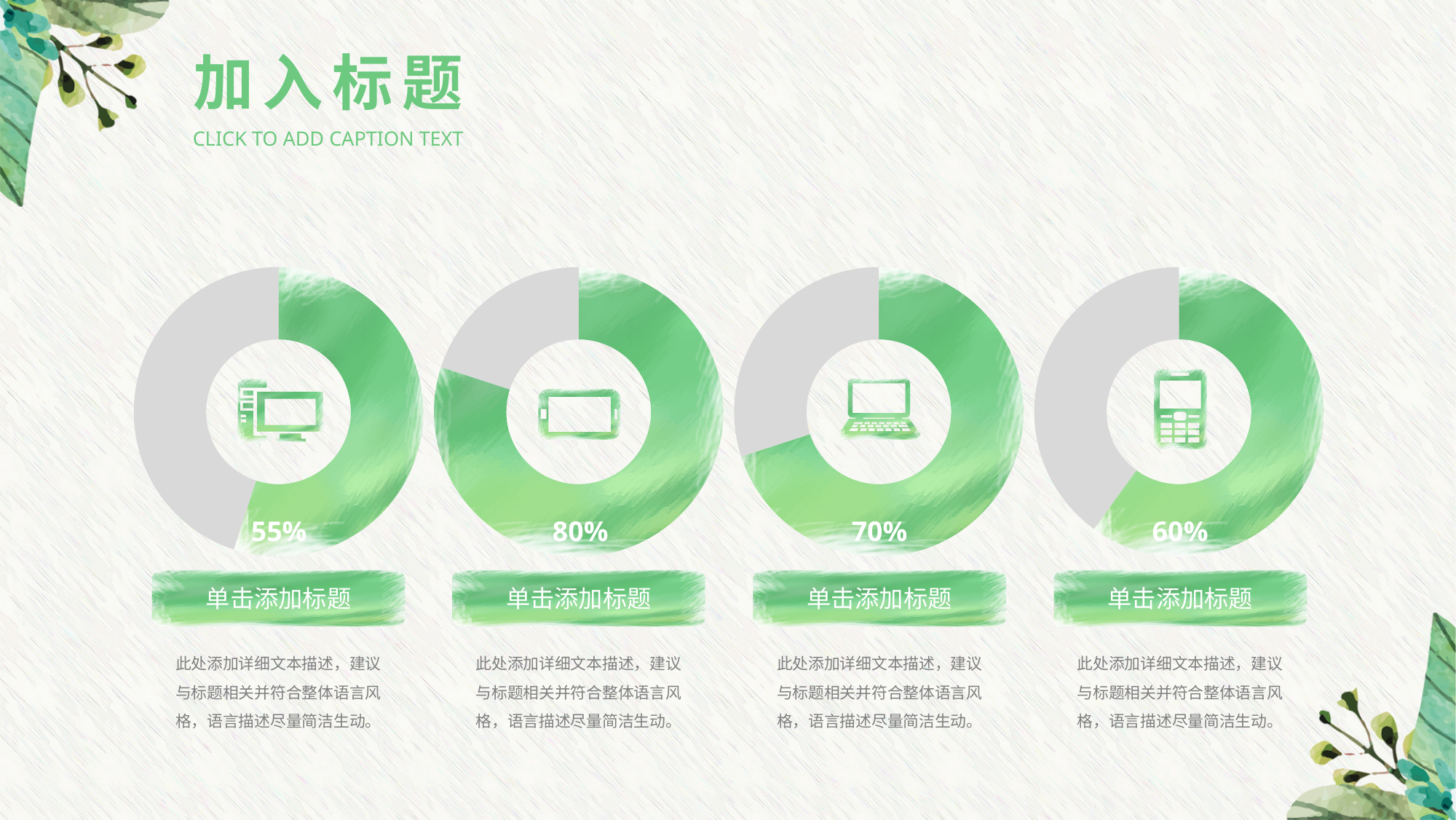
What colour is the filled (value) portion of each donut chart? Green What percentage is shown on the third donut chart from the left (with the laptop icon)? 70% Which is larger: the percentage on the third donut chart (laptop icon) or the percentage on the rightmost donut chart (mobile phone icon)? The third donut chart (laptop icon), 70% What is the difference between the percentage on the second donut chart (80%) and the percentage on the leftmost donut chart (55%)? 25% What percentage is shown on the leftmost donut chart (with the desktop computer icon)? 55% What is the difference between the percentage on the third donut chart (70%) and the rightmost donut chart (60%)? 10% What percentage is shown on the rightmost donut chart (with the mobile phone icon)? 60% What percentage is shown on the second donut chart from the left (with the tablet icon)? 80% What kind of chart is used to display the percentages on this slide? Donut (pie) chart Which of the four donut charts shows the highest percentage? The second from the left (tablet icon), 80% Which of the four donut charts shows the lowest percentage? The leftmost (desktop computer icon), 55% How many donut charts are shown on the slide? 4